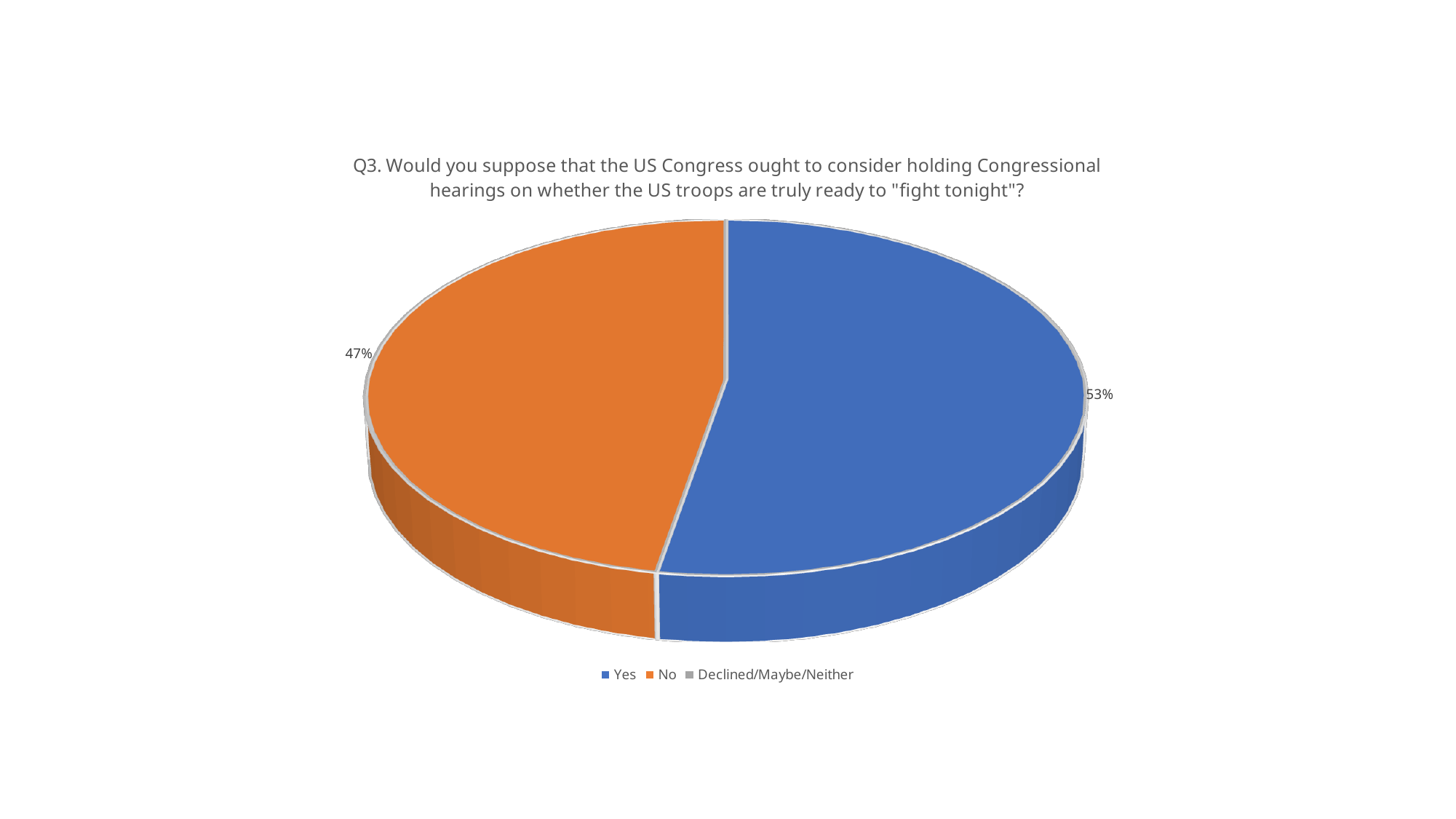
Is the share for No greater or less than 50%? less How many entries does the legend list? 3 Which of the two visible slices is larger, Yes or No? Yes What kind of chart is shown on the slide? pie chart What is the share of the pie for the Yes slice? 53% What is the difference in percentage points between the Yes and No shares? 6% What percentage of respondents answered Yes? 53% What percentage of respondents answered No? 47% Which response has the largest share of the pie? Yes What colour is the Yes slice? blue What colour is the No slice? orange